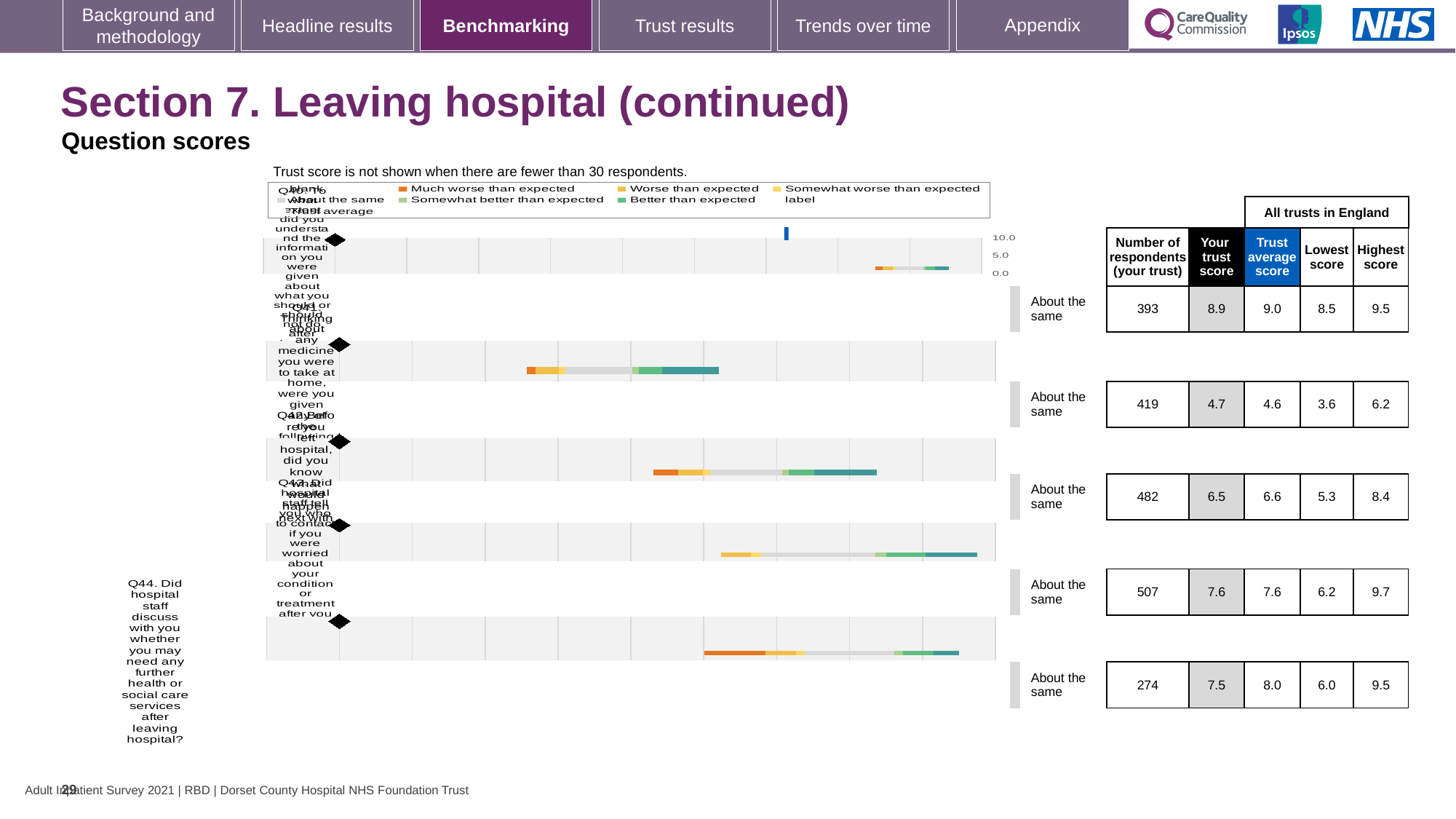
What is the highest number of respondents shown for any question on this slide? 507 For Q44, which is larger: your trust score or the trust average score? Trust average score How many respondents from your trust answered Q44? 274 What is the trust average score for Q44? 8.0 What is the highest score across all trusts in England for Q44? 9.5 According to the note above the chart, when is the trust score not shown? When there are fewer than 30 respondents What benchmark category is shown next to every question on this slide? About the same What is the 'Your trust score' for Q44 (Did hospital staff discuss with you whether you may need any further health or social care services after leaving hospital?)? 7.5 How many question rows are plotted in the benchmarking chart? 5 What kind of chart is used to show the question scores? Bar chart What is the lowest number of respondents shown for any question on this slide? 274 What is the difference between the highest score and the lowest score for Q44? 3.5